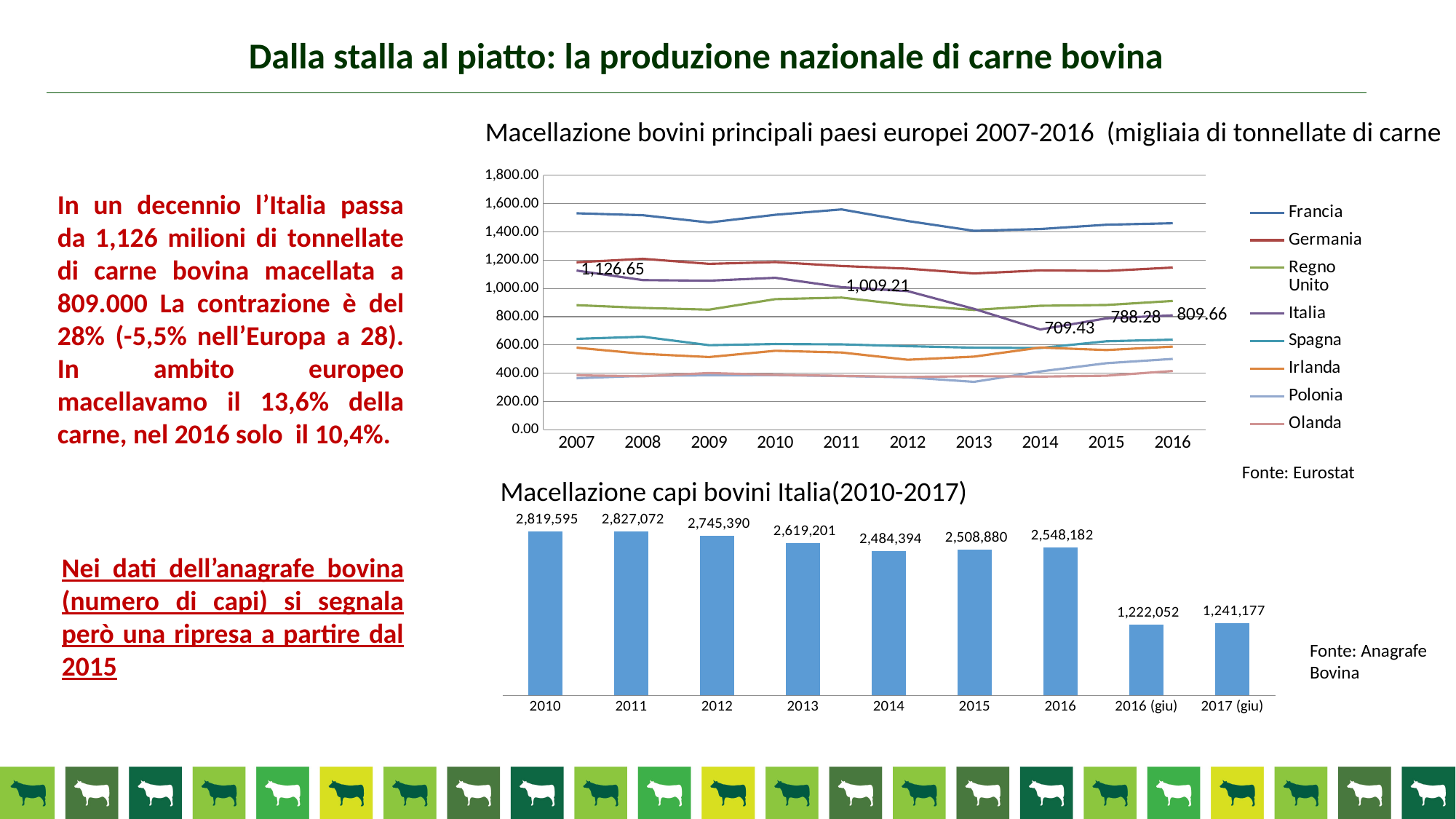
In the line chart 'Macellazione bovini principali paesi europei 2007-2016', what is the difference between the Italia values for 2016 and 2015? 21.38 In the line chart 'Macellazione bovini principali paesi europei 2007-2016', which country has the highest values across the whole period? Francia In the line chart 'Macellazione bovini principali paesi europei 2007-2016', what is the value for Italia in 2014? 709.43 In the bar chart 'Macellazione capi bovini Italia(2010-2017)', what is the value for 2014? 2,484,394 In the line chart 'Macellazione bovini principali paesi europei 2007-2016', what is the value for Italia in 2007? 1,126.65 In the bar chart 'Macellazione capi bovini Italia(2010-2017)', how many bars are shown? 9 In the line chart 'Macellazione bovini principali paesi europei 2007-2016', is the value for Francia in 2011 greater or less than 1,400.00? greater In the bar chart 'Macellazione capi bovini Italia(2010-2017)', what is the difference between the values for 2017 (giu) and 2016 (giu)? 19,125 What kind of chart is 'Macellazione capi bovini Italia(2010-2017)'? bar chart In the bar chart 'Macellazione capi bovini Italia(2010-2017)', which full-year category (2010-2016) has the highest value? 2011 In the line chart 'Macellazione bovini principali paesi europei 2007-2016', what is the value for Italia in 2016? 809.66 In the line chart 'Macellazione bovini principali paesi europei 2007-2016', how many series does the legend list? 8